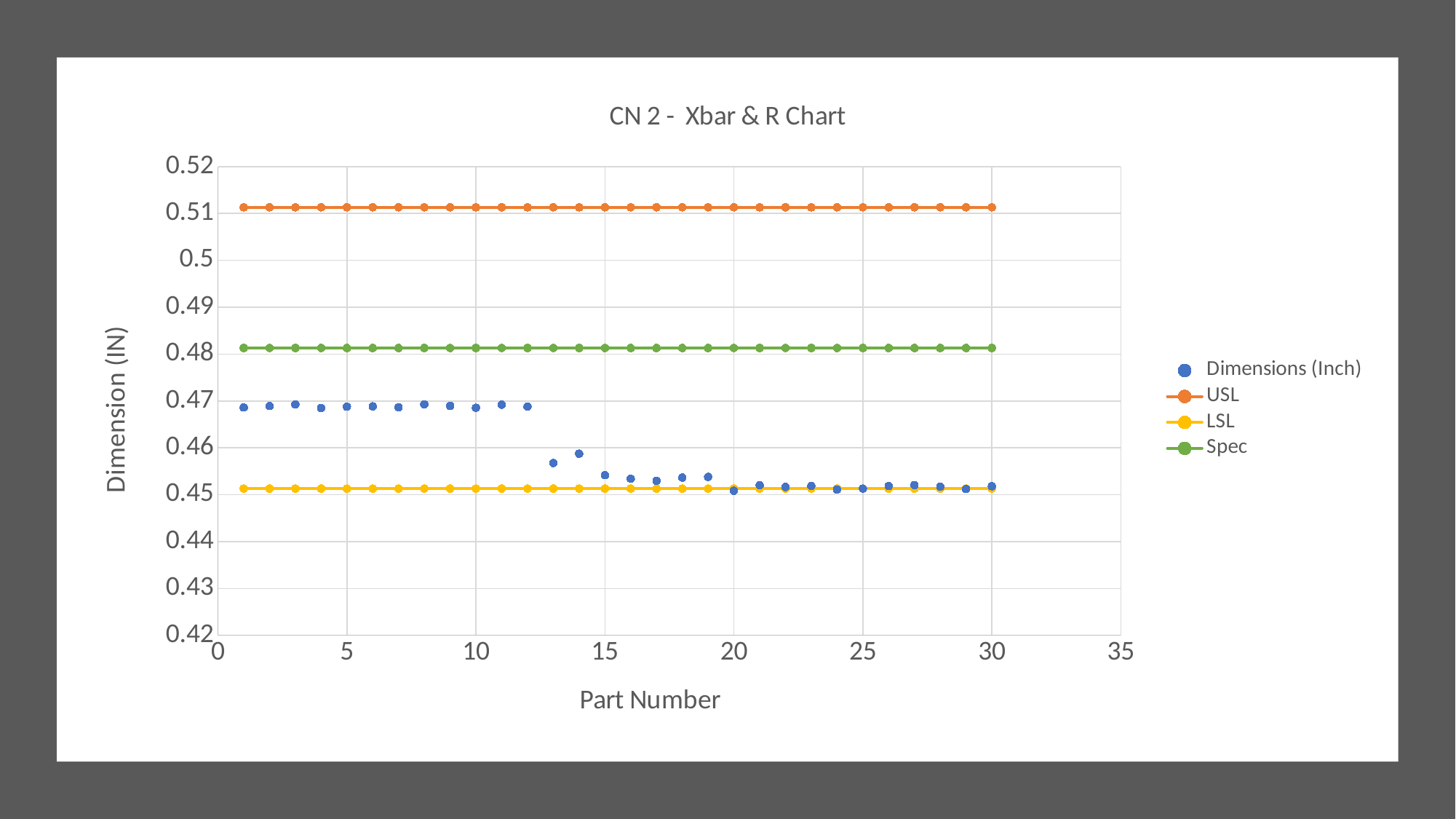
Is the Dimensions (Inch) value at part number 1 greater or less than 0.46? greater What kind of chart is shown? scatter chart Is the value of the LSL series greater or less than 0.46? less Is the value of the USL series greater or less than 0.5? greater What are the series names listed in the legend? Dimensions (Inch), USL, LSL, Spec Do the Dimensions (Inch) values rise or fall as the part number increases? fall Which series has the highest values, USL or Spec? USL What is the title of the chart? CN 2 - Xbar & R Chart How many part numbers are plotted for the Dimensions (Inch) series? 30 How many series does the legend list? 4